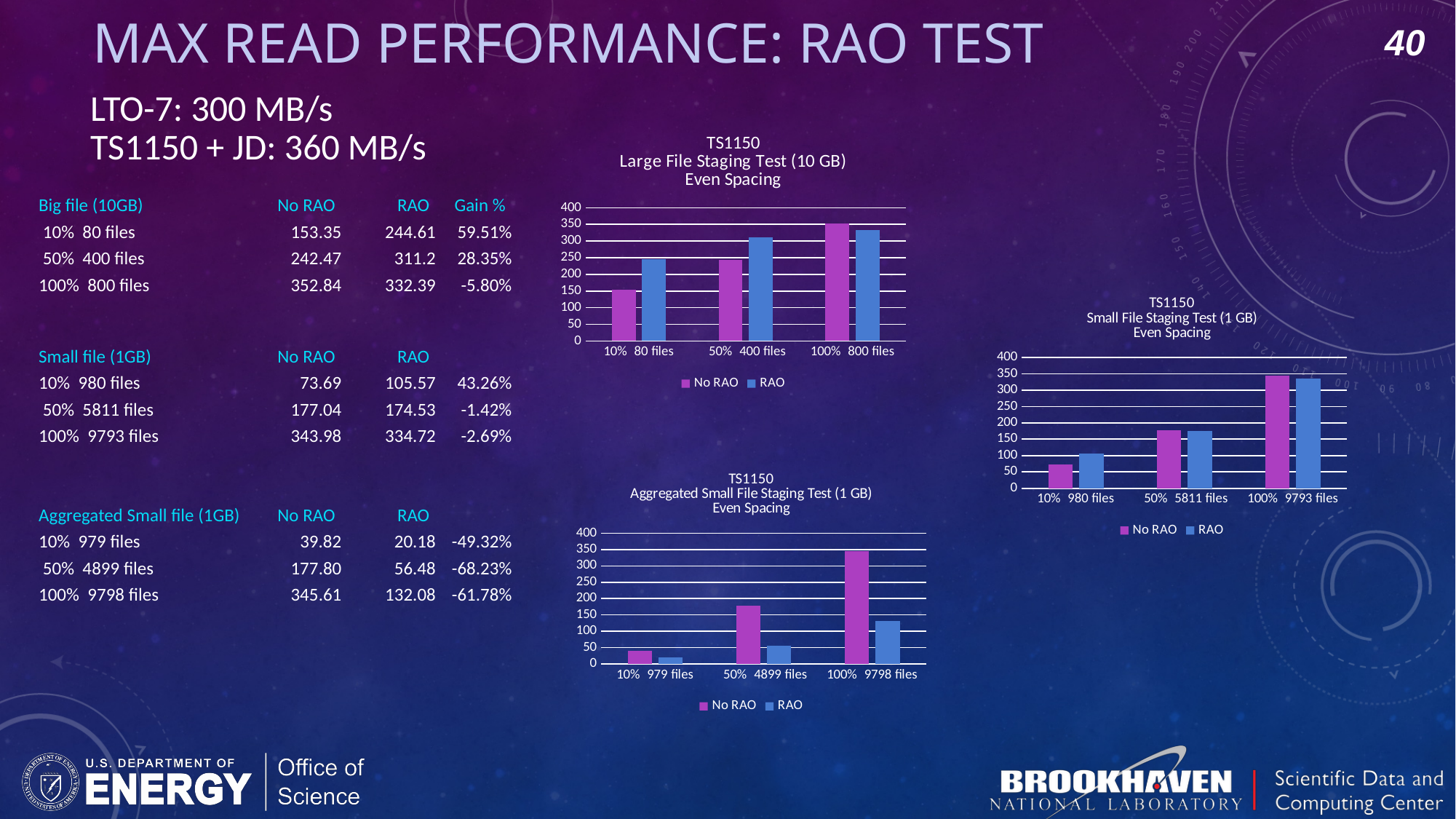
In the 'TS1150 Small File Staging Test (1 GB) Even Spacing' chart, what colour are the No RAO bars? purple How many categories are shown on the x axis of the 'TS1150 Small File Staging Test (1 GB) Even Spacing' chart? 3 In the 'TS1150 Aggregated Small File Staging Test (1 GB) Even Spacing' chart, what is the difference between the No RAO and RAO values for 100% 9798 files? 213.53 In the 'TS1150 Large File Staging Test (10 GB) Even Spacing' chart, what is the No RAO value for 50% 400 files? 242.47 In the 'TS1150 Aggregated Small File Staging Test (1 GB) Even Spacing' chart, which category has the lowest RAO bar? 10% 979 files What kind of chart is the 'TS1150 Large File Staging Test (10 GB) Even Spacing' chart? bar chart In the 'TS1150 Small File Staging Test (1 GB) Even Spacing' chart, do the No RAO bars rise or fall from left to right along the x axis? rise In the 'TS1150 Aggregated Small File Staging Test (1 GB) Even Spacing' chart, is the No RAO value for 100% 9798 files greater or less than 300? greater In the 'TS1150 Large File Staging Test (10 GB) Even Spacing' chart, for 10% 80 files, which is larger: No RAO or RAO? RAO In the 'TS1150 Aggregated Small File Staging Test (1 GB) Even Spacing' chart, is the RAO value for 10% 979 files greater or less than 50? less How many series does the legend of the 'TS1150 Aggregated Small File Staging Test (1 GB) Even Spacing' chart list? 2 In the 'TS1150 Large File Staging Test (10 GB) Even Spacing' chart, which category has the highest No RAO bar? 100% 800 files